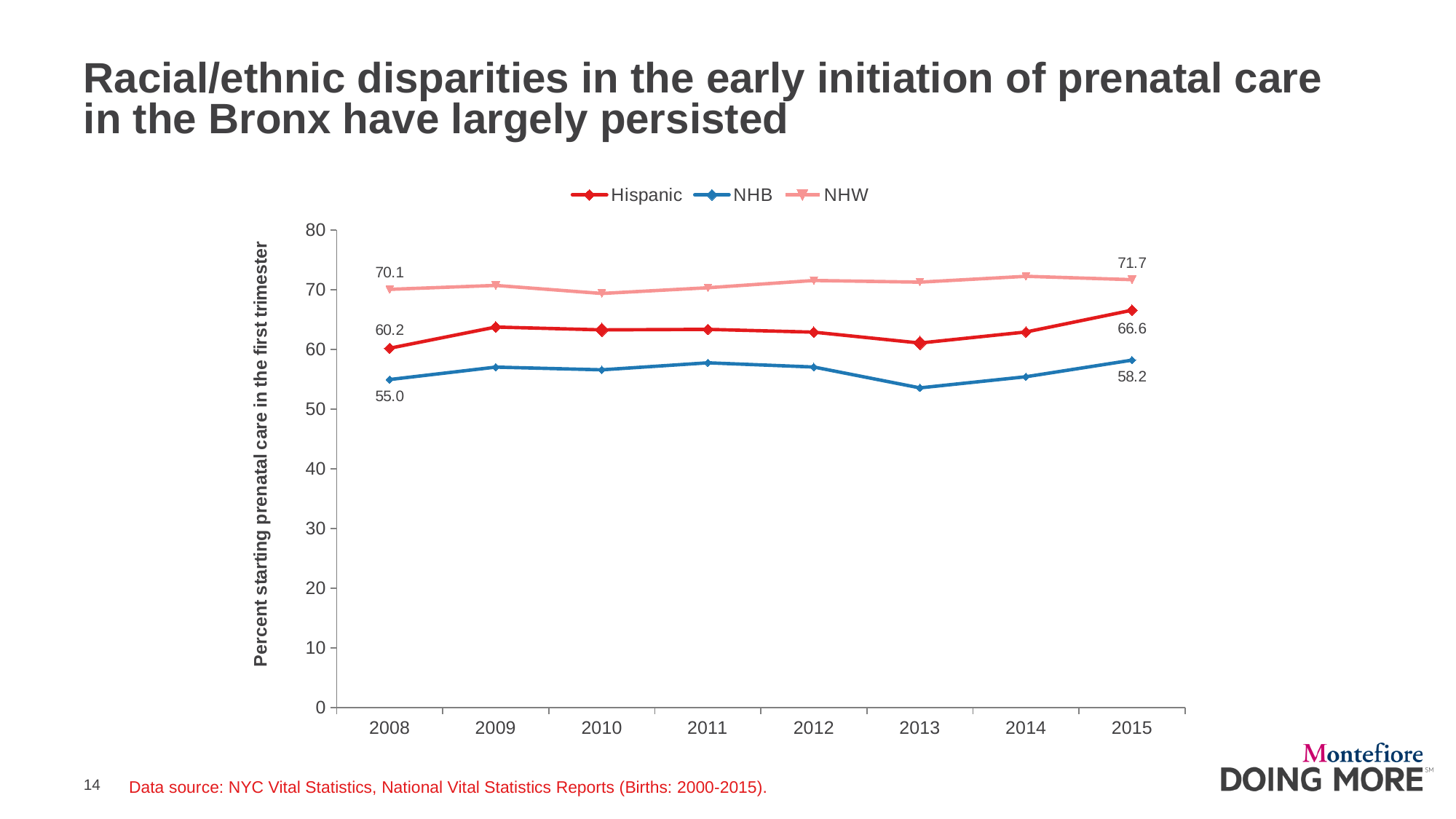
How many years are shown on the x axis? 8 What was the NHW value in 2015? 71.7 Which series had the highest value in 2015? NHW Is the NHB value in 2013 greater or less than 60? less Which series had the lowest value in 2008? NHB What was the percent of Hispanic mothers starting prenatal care in the first trimester in 2008? 60.2 By how much did the Hispanic value increase from 2008 to 2015? 6.4 What was the Hispanic value in 2015? 66.6 What is the difference between the NHW and NHB values in 2015? 13.5 What kind of chart is shown on the slide? line chart What was the NHB value in 2008? 55.0 How many series does the legend list? 3